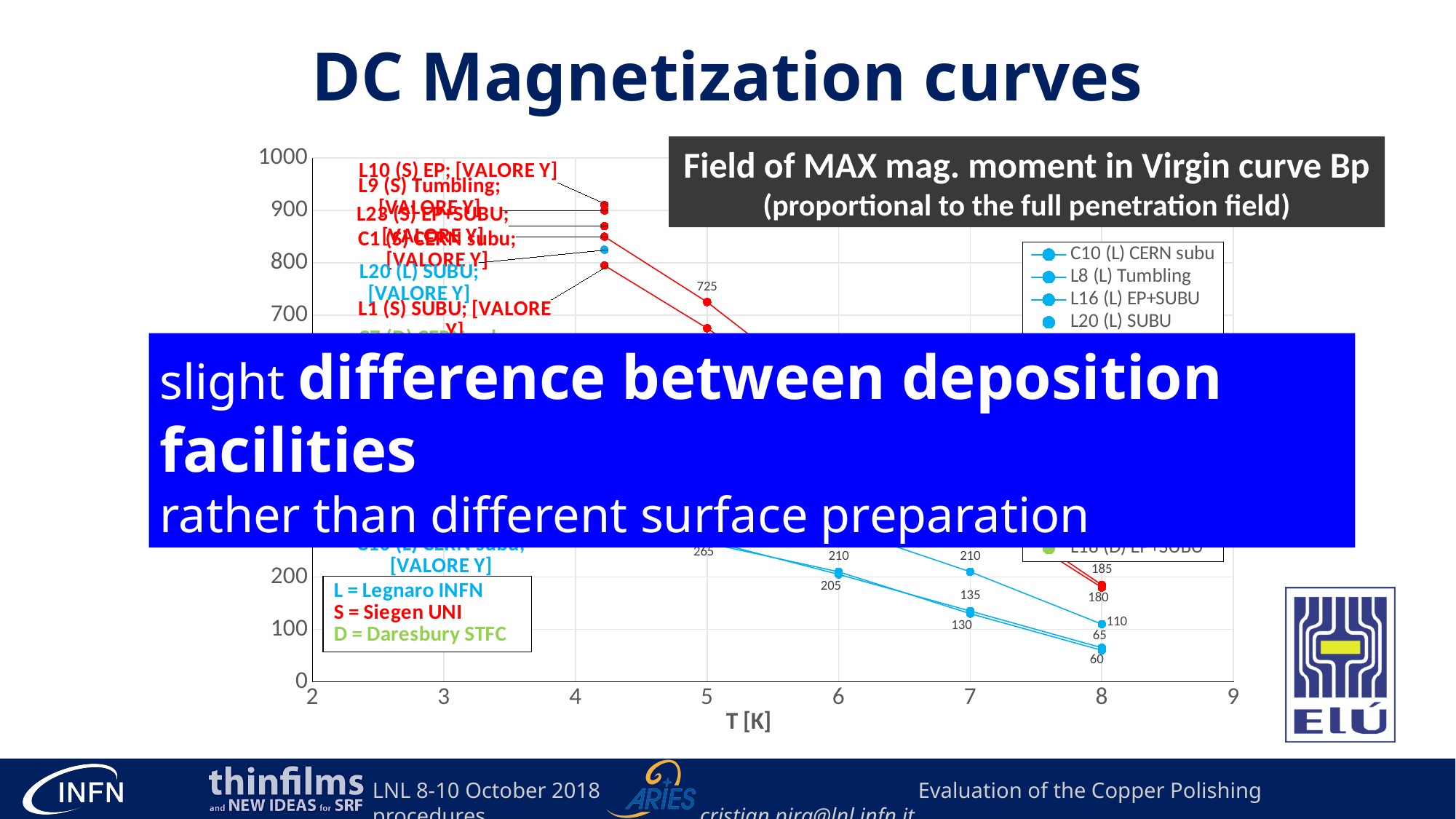
What is the lowest value shown on the x axis of the chart? 2 What is the value of the red data label printed near T = 5 K at the top of the chart? 725 What kind of chart is shown on the slide? line chart Is the red point labelled at T = 5 K greater or less than 700? greater What is the lowest data label printed at T = 8 K? 60 What is the difference between the highest (185) and lowest (60) data labels printed at T = 8 K? 125 What is the highest value shown on the y axis of the chart? 1000 Which is larger, the data label 210 at T = 7 K or the data label 135 at T = 7 K? 210 According to the key box on the chart, what does the letter S stand for? Siegen UNI What is the highest data label printed at T = 8 K? 185 Do the plotted values rise or fall as T [K] increases along the x axis? fall